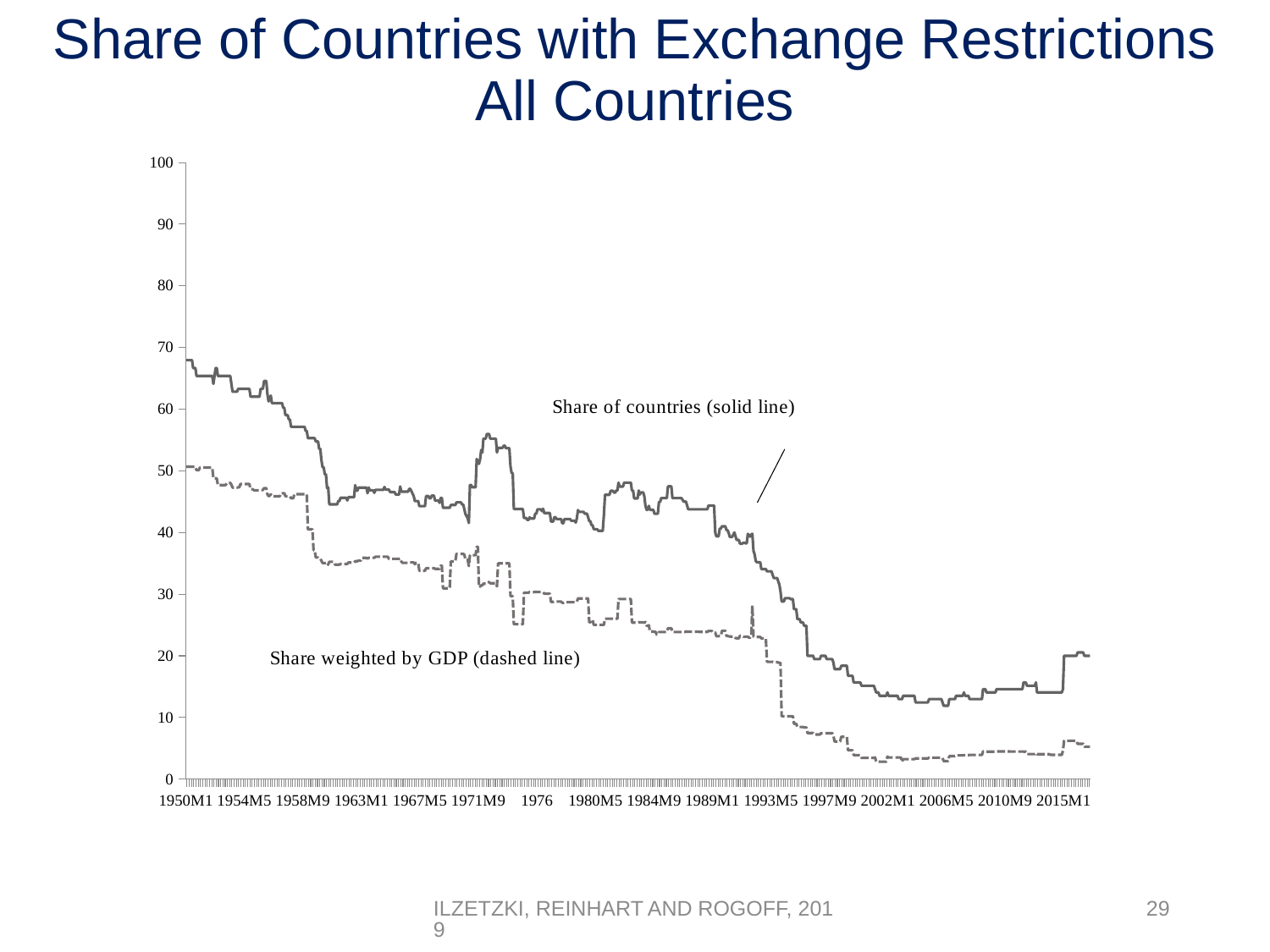
Does the share weighted by GDP (dashed line) generally rise or fall over the period shown? fall At 1950M1, which is higher: the share of countries (solid line) or the share weighted by GDP (dashed line)? Share of countries (solid line) Does the share of countries (solid line) generally rise or fall from 1950M1 to 2015M1? fall Is the share weighted by GDP (dashed line) at 1950M1 greater or less than 60? less Is the share weighted by GDP (dashed line) around 2002M1 greater or less than 10? less What kind of chart is shown on the slide? line chart Is the share of countries (solid line) at 2015M1 greater or less than 30? less What is the title of the chart on the slide? Share of Countries with Exchange Restrictions All Countries How many series are plotted on the chart? 2 Which series is drawn as a dashed line? Share weighted by GDP